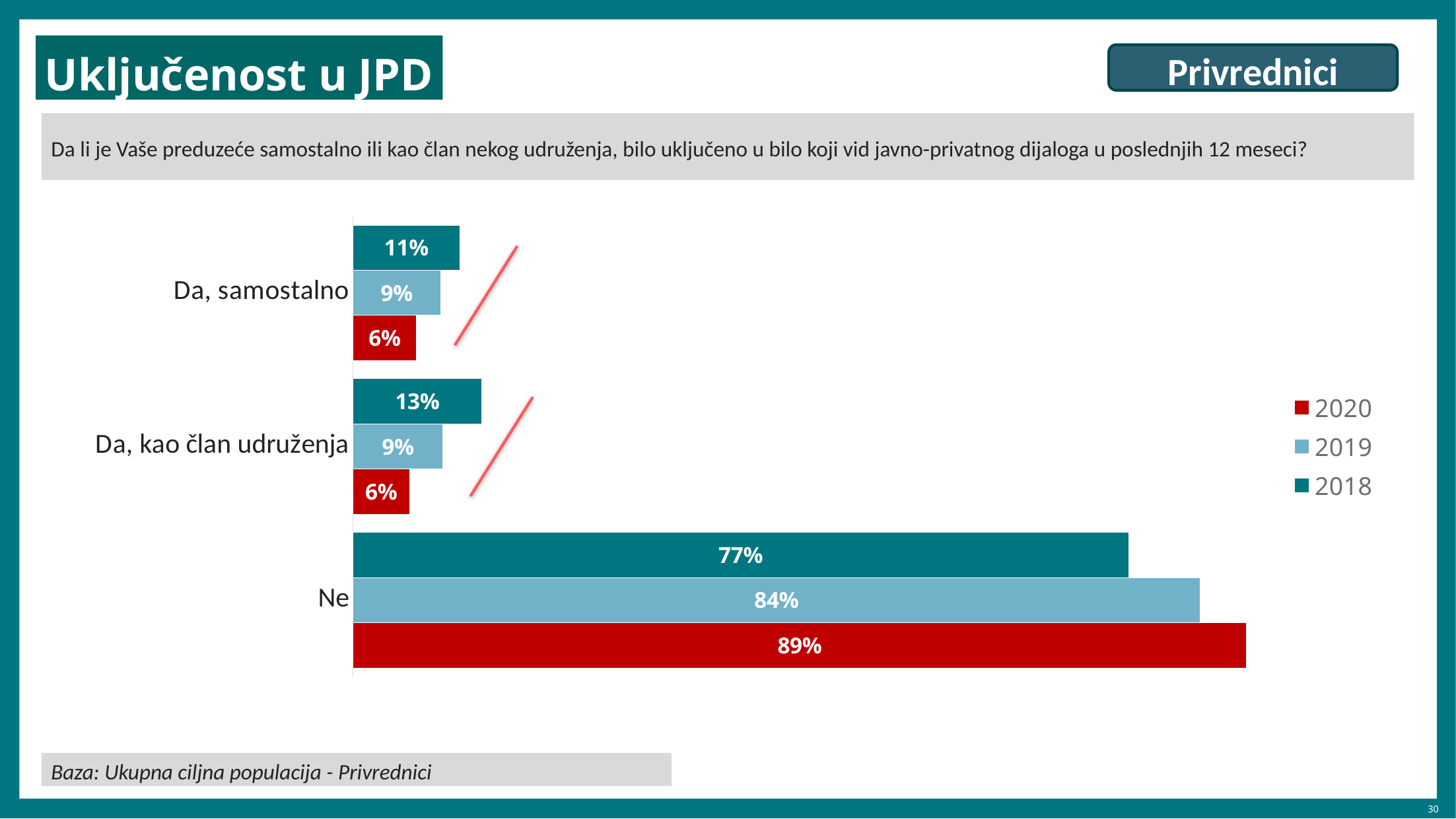
What is the value for "Da, kao član udruženja" in the 2019 series? 9% How many series does the legend list? 3 What is the difference between the 2018 and 2020 values for "Da, kao član udruženja"? 7% What kind of chart is shown on the slide? Bar chart Which colour represents the 2020 series in the legend? Red Which category has the highest value in the 2019 series? Ne Which category has the lowest value in the 2018 series? Da, samostalno What is the value for "Da, samostalno" in the 2018 series? 11% What is the value for "Ne" in the 2020 series? 89% Which is larger for "Ne": the 2019 value or the 2018 value? 2019 How many categories are shown on the chart? 3 What is the difference between the 2020 and 2018 values for "Ne"? 12%